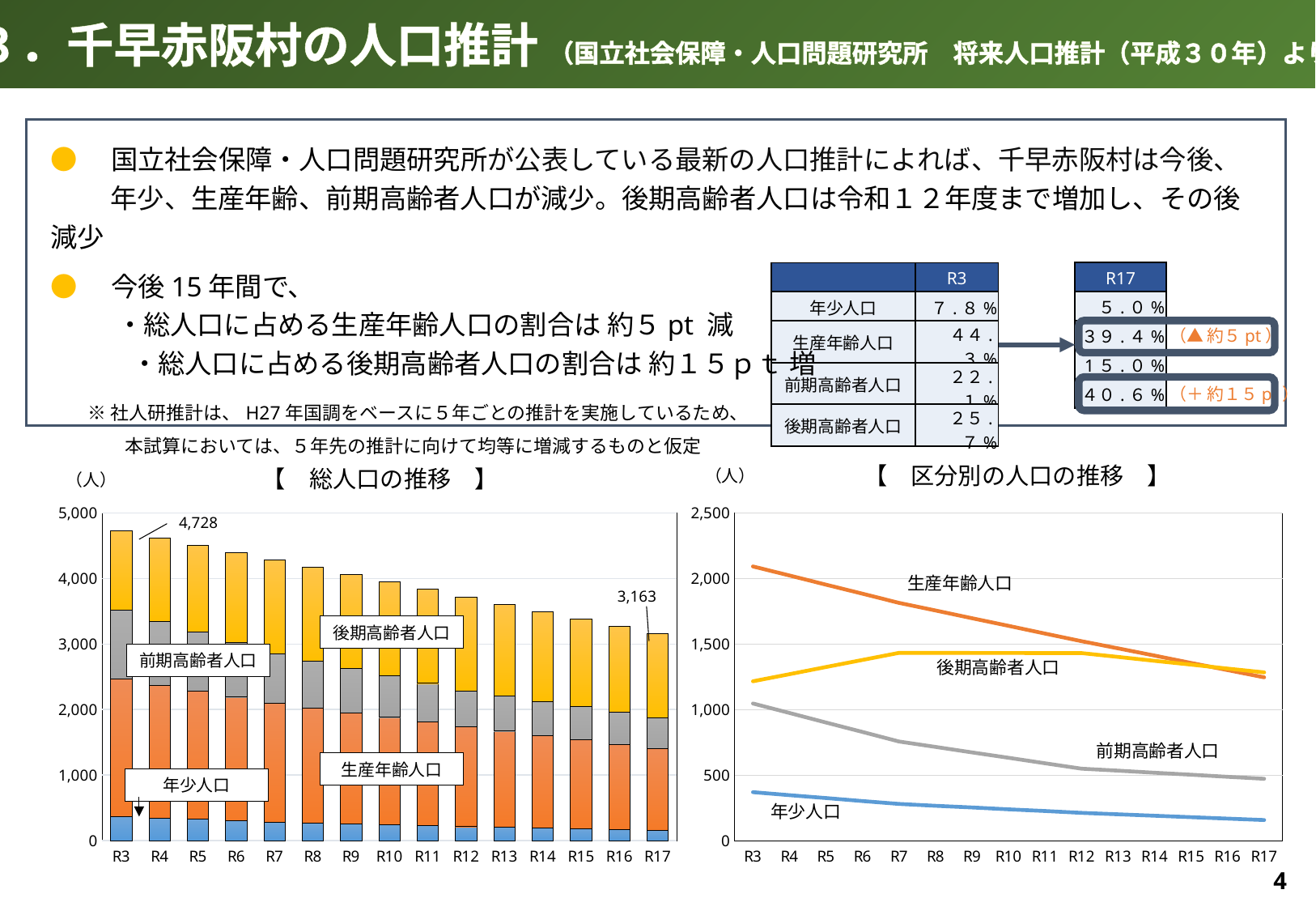
In the right chart 【区分別の人口の推移】, how many population categories are plotted as lines? 4 In the left chart 【総人口の推移】, how many years are shown on the x axis? 15 In the right chart 【区分別の人口の推移】, which category has the lowest value at R17? 年少人口 In the left chart 【総人口の推移】, what is the total population shown for R3? 4,728 In the left chart 【総人口の推移】, what is the difference between the R3 total (4,728) and the R17 total (3,163)? 1,565 What kind of chart is the right chart titled 【区分別の人口の推移】? line chart In the left chart 【総人口の推移】, is the total for R13 greater or less than 4,000? less In the right chart 【区分別の人口の推移】, is the value of 生産年齢人口 at R3 greater or less than 2,000? greater What kind of chart is the left chart titled 【総人口の推移】? bar chart In the left chart 【総人口の推移】, what is the total population shown for R17? 3,163 In the right chart 【区分別の人口の推移】, which category has the highest value at R3? 生産年齢人口 In the left chart 【総人口の推移】, does the total population rise or fall from R3 to R17? fall